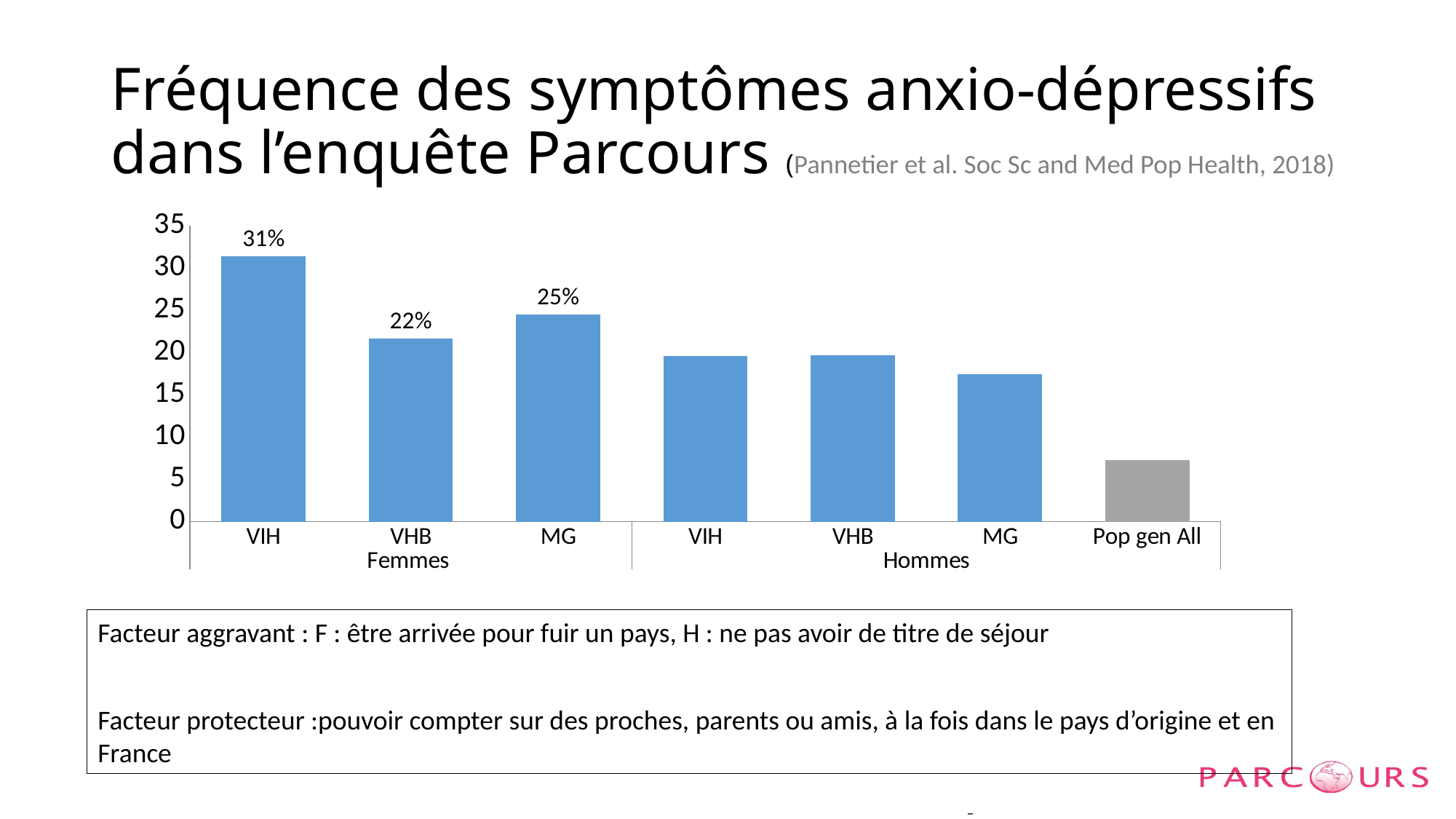
Is the value for Pop gen All greater or less than 10? less What is the difference between the VIH and VHB values in the Femmes group? 9% Which bar has the lowest value? Pop gen All How many bars are shown in the chart? 7 What is the value for VIH in the Femmes group? 31% Is the value for VIH in the Hommes group greater or less than 15? greater What kind of chart is shown on the slide? bar chart In the Femmes group, which is larger: MG or VHB? MG Which bar has the highest value? VIH (Femmes) Is the value for MG in the Hommes group greater or less than 20? less What is the value for VHB in the Femmes group? 22% What is the value for MG in the Femmes group? 25%